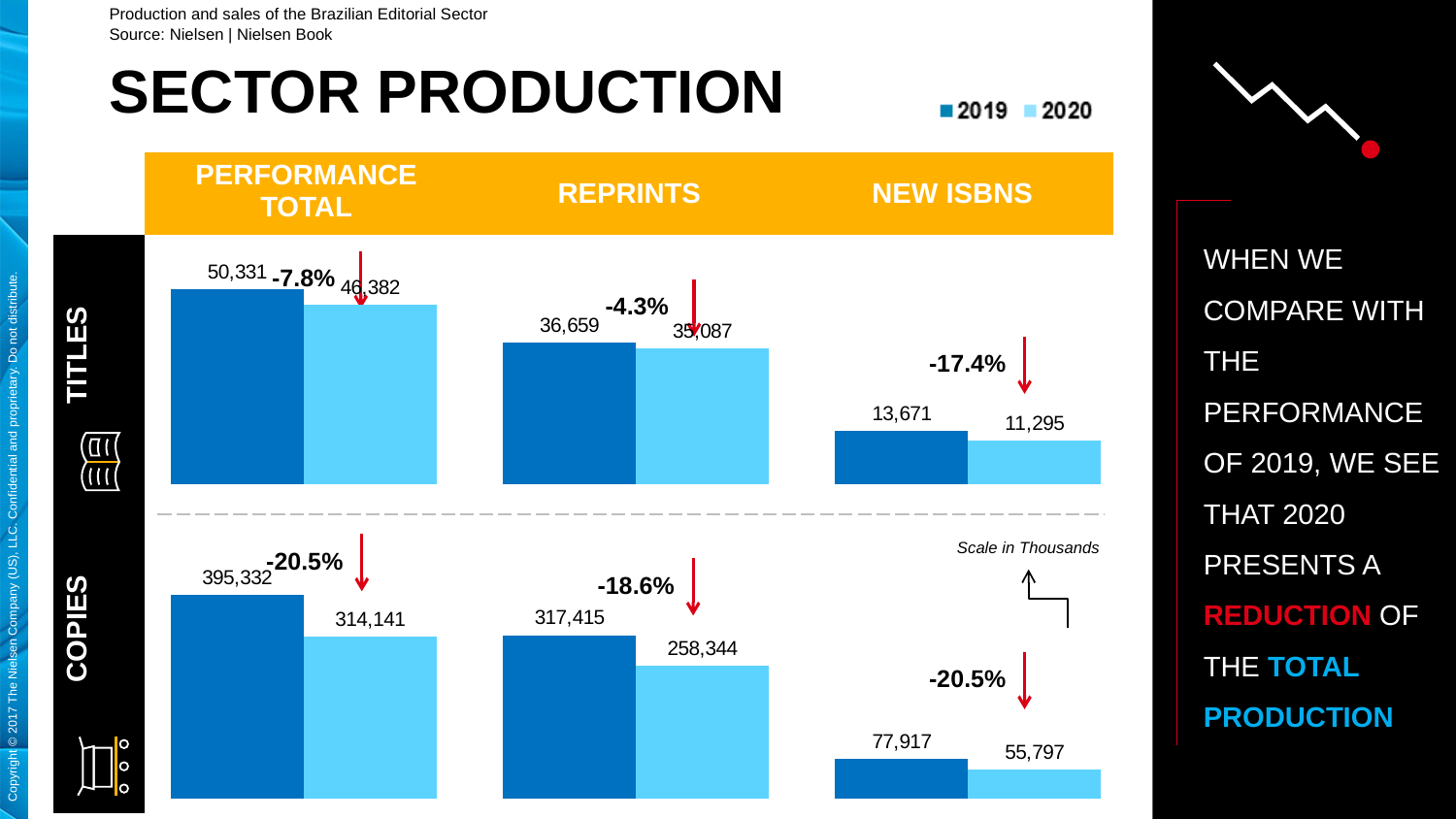
In the COPIES / REPRINTS chart, what is the value for 2019? 317,415 In the COPIES / PERFORMANCE TOTAL chart, what is the value for 2020? 314,141 In the TITLES / NEW ISBNS chart, what is the value for 2020? 11,295 In the TITLES / NEW ISBNS chart, what is the difference between the 2019 and 2020 values? 2,376 In the COPIES / NEW ISBNS chart, what is the value for 2020? 55,797 In the TITLES / PERFORMANCE TOTAL chart, what is the value for 2019? 50,331 How many series does the legend at the top of the slide list? 2 In the COPIES / NEW ISBNS chart, what is the difference between the 2019 and 2020 values? 22,120 In the TITLES / REPRINTS chart, what is the value for 2019? 36,659 In the COPIES / PERFORMANCE TOTAL chart, which year has the larger value, 2019 or 2020? 2019 In the COPIES / REPRINTS chart, do the values rise or fall from 2019 to 2020? fall What kind of chart is used in the TITLES / REPRINTS panel? bar chart